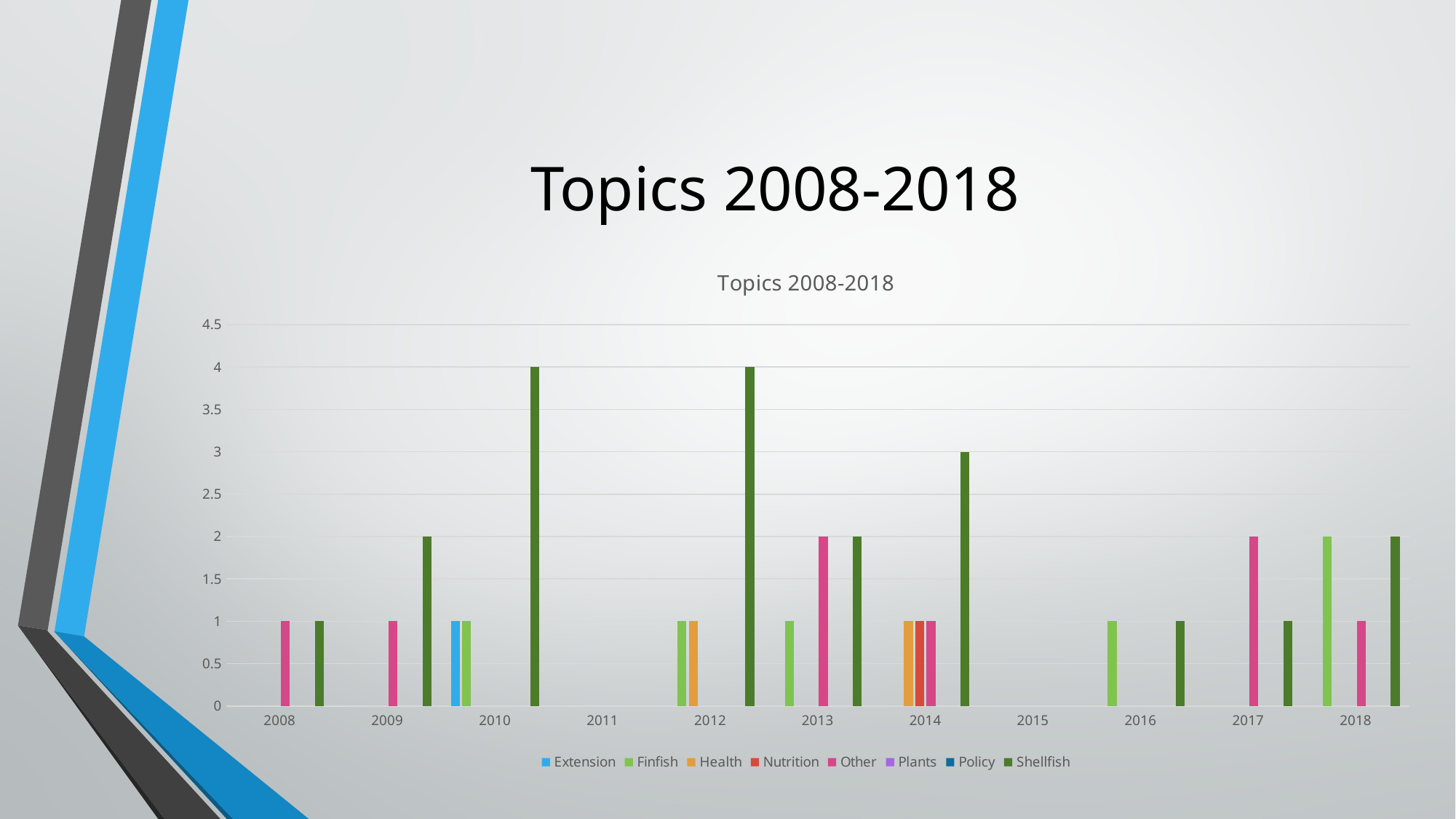
What kind of chart is shown on the slide? bar chart How many years are shown along the x axis of the chart? 11 What is the value for Shellfish in 2010? 4 Is the value for Shellfish in 2012 greater or less than 3? greater How many series does the legend list? 8 Which is larger, the Shellfish value in 2014 or the Shellfish value in 2009? 2014 What is the value for Shellfish in 2014? 3 What is the title of the chart? Topics 2008-2018 What is the value for Finfish in 2018? 2 What is the value for Other in 2013? 2 Which series is listed first in the legend? Extension What is the difference between the Shellfish value in 2010 and the Shellfish value in 2014? 1